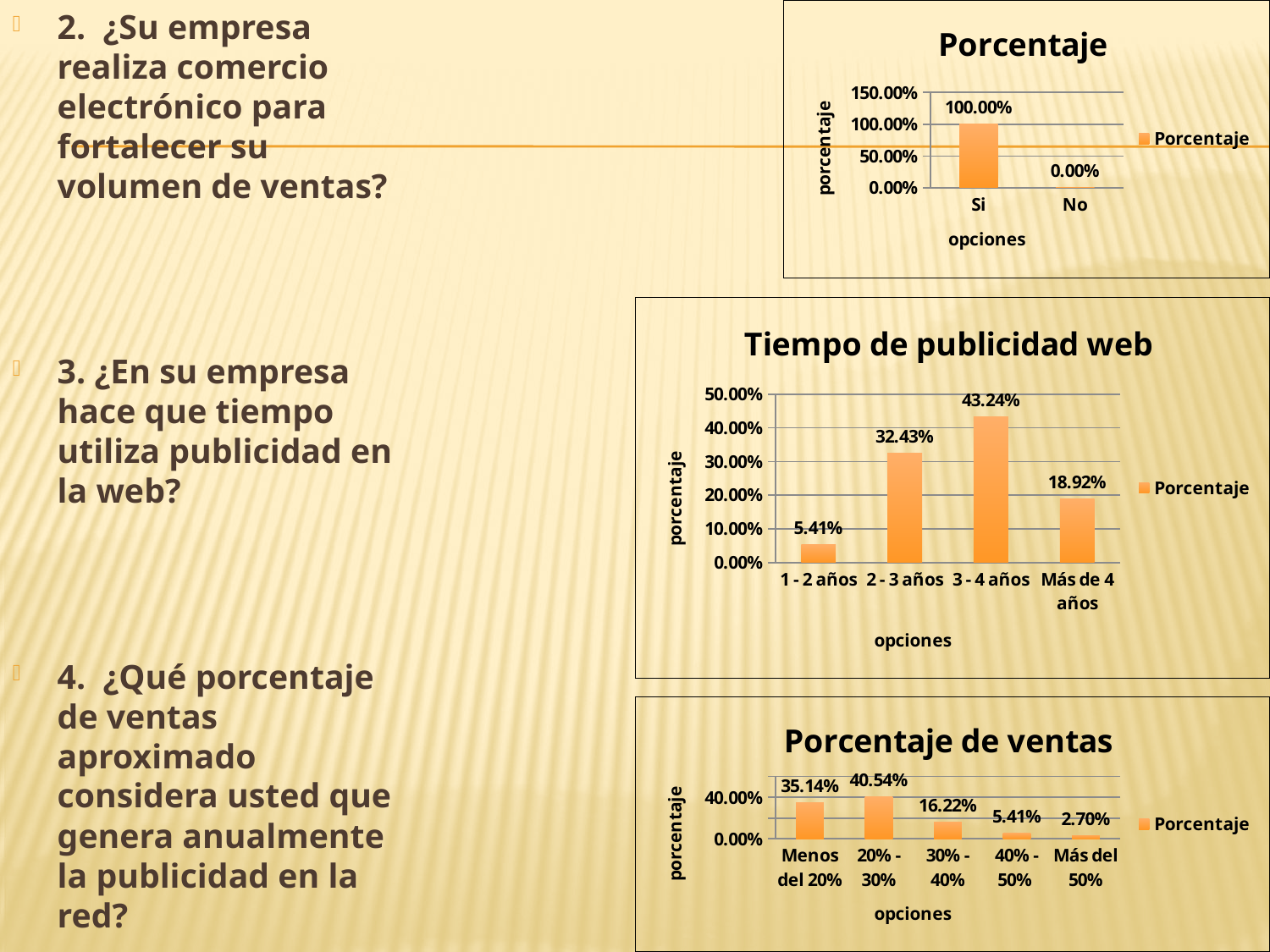
In the 'Tiempo de publicidad web' chart, how many categories are shown on the x axis? 4 In the 'Porcentaje de ventas' chart, how many categories are shown on the x axis? 5 In the 'Porcentaje de ventas' chart, which category has the highest value? 20% - 30% In the 'Tiempo de publicidad web' chart, what is the difference between '3 - 4 años' and '2 - 3 años'? 10.81% In the 'Porcentaje de ventas' chart, what is the value for 'Más del 50%'? 2.70% In the 'Porcentaje' chart, what is the value for 'No'? 0.00% In the 'Porcentaje' chart, what is the value for 'Si'? 100.00% In the 'Tiempo de publicidad web' chart, is the value for 'Más de 4 años' greater or less than 20.00%? less What type of chart is 'Tiempo de publicidad web'? bar chart In the 'Tiempo de publicidad web' chart, which category has the lowest value? 1 - 2 años In the 'Porcentaje de ventas' chart, which is larger: 'Menos del 20%' or '30% - 40%'? Menos del 20% In the 'Tiempo de publicidad web' chart, what is the value for '3 - 4 años'? 43.24%